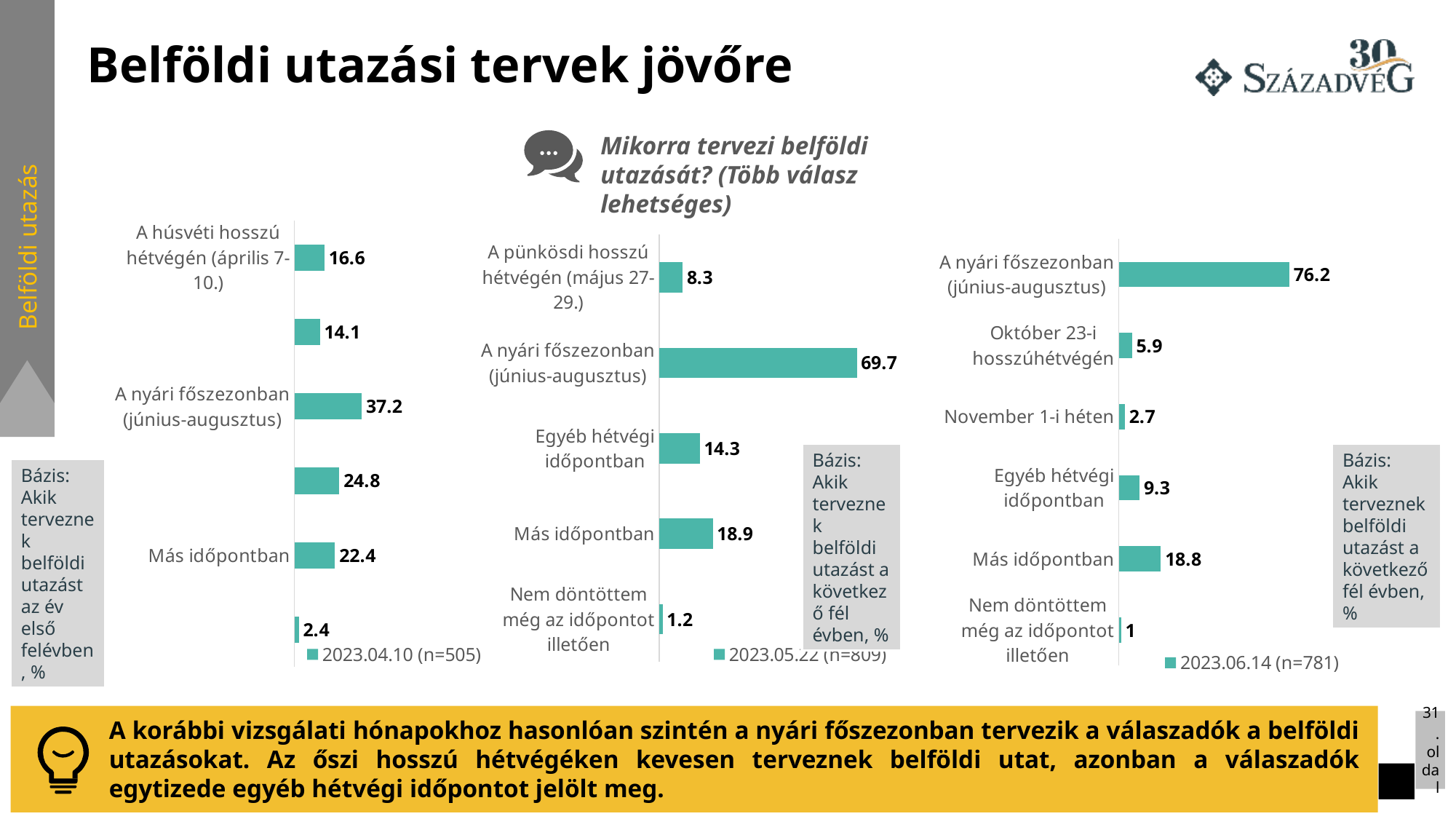
What is the legend entry of the middle chart? 2023.05.22 (n=809) How many categories are shown in the 2023.06.14 chart on the right? 6 In the 2023.04.10 (n=505) chart on the left, what is the value for 'A húsvéti hosszú hétvégén (április 7-10.)'? 16.6 In the 2023.05.22 chart in the middle, what is the value for 'A pünkösdi hosszú hétvégén (május 27-29.)'? 8.3 How many categories are shown in the 2023.05.22 chart in the middle? 5 In the 2023.05.22 chart in the middle, which category has the highest value? A nyári főszezonban (június-augusztus) In the 2023.06.14 chart on the right, what is the difference between 'Más időpontban' and 'Egyéb hétvégi időpontban'? 9.5 In the 2023.05.22 chart in the middle, which is larger: 'Más időpontban' or 'Egyéb hétvégi időpontban'? Más időpontban In the 2023.04.10 chart on the left, what is the difference between 'A nyári főszezonban (június-augusztus)' and 'Más időpontban'? 14.8 In the 2023.06.14 chart on the right, which category has the lowest value? Nem döntöttem még az időpontot illetően In the 2023.06.14 (n=781) chart on the right, what is the value for 'A nyári főszezonban (június-augusztus)'? 76.2 What type of chart is the 2023.06.14 chart on the right? Bar chart